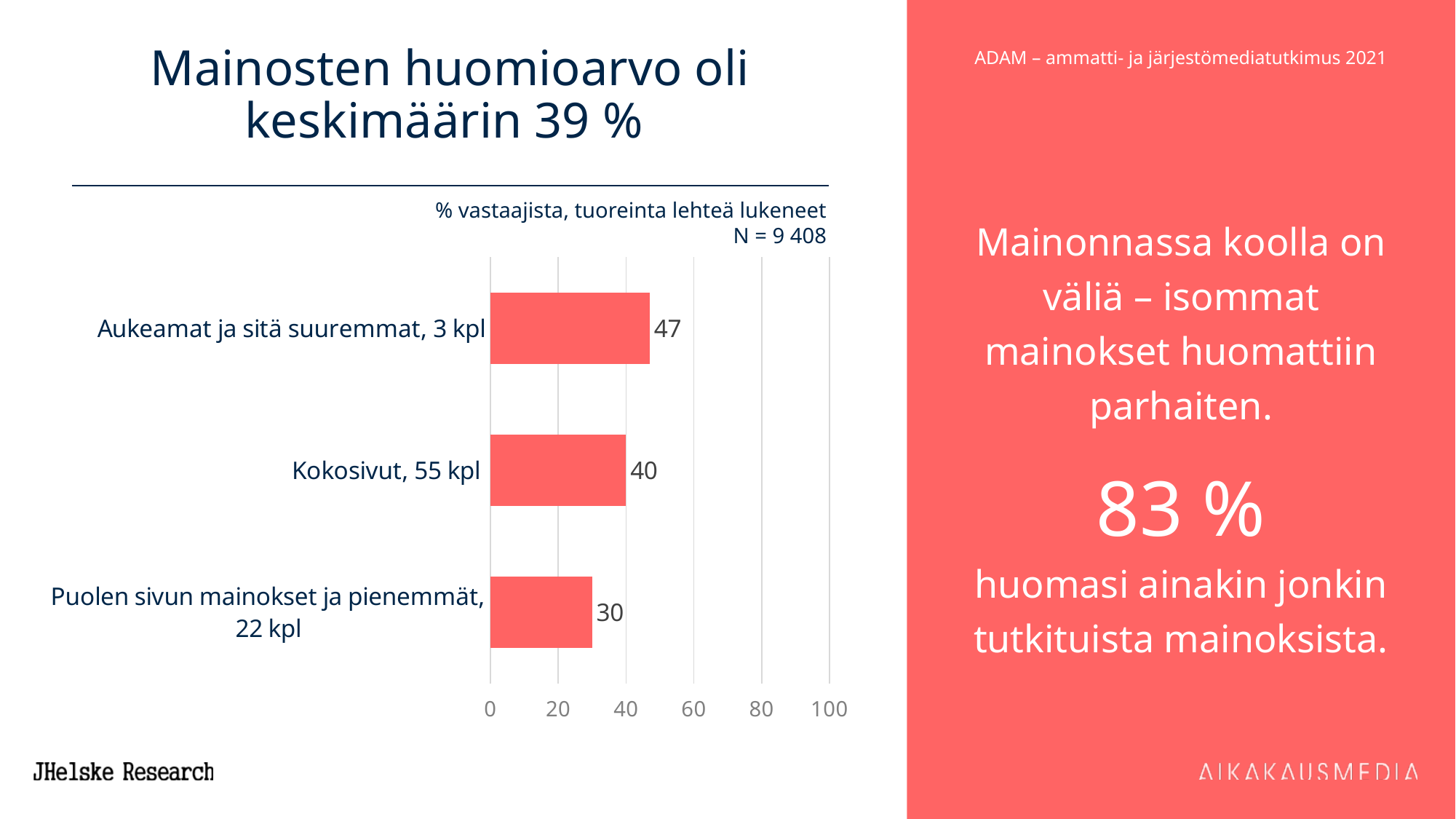
What is the difference between the values for "Aukeamat ja sitä suuremmat, 3 kpl" and "Puolen sivun mainokset ja pienemmät, 22 kpl"? 17 What is the maximum value shown on the chart's value axis? 100 Is the value for "Aukeamat ja sitä suuremmat, 3 kpl" greater or less than 40? greater Which is larger, the value for "Kokosivut, 55 kpl" or the value for "Puolen sivun mainokset ja pienemmät, 22 kpl"? Kokosivut, 55 kpl What is the value for "Puolen sivun mainokset ja pienemmät, 22 kpl"? 30 What is the value for "Aukeamat ja sitä suuremmat, 3 kpl"? 47 What is the difference between the values for "Kokosivut, 55 kpl" and "Puolen sivun mainokset ja pienemmät, 22 kpl"? 10 What is the value for "Kokosivut, 55 kpl"? 40 Which category has the highest value? Aukeamat ja sitä suuremmat, 3 kpl How many categories are shown in the chart? 3 What kind of chart is shown on the slide? bar chart Which category has the lowest value? Puolen sivun mainokset ja pienemmät, 22 kpl